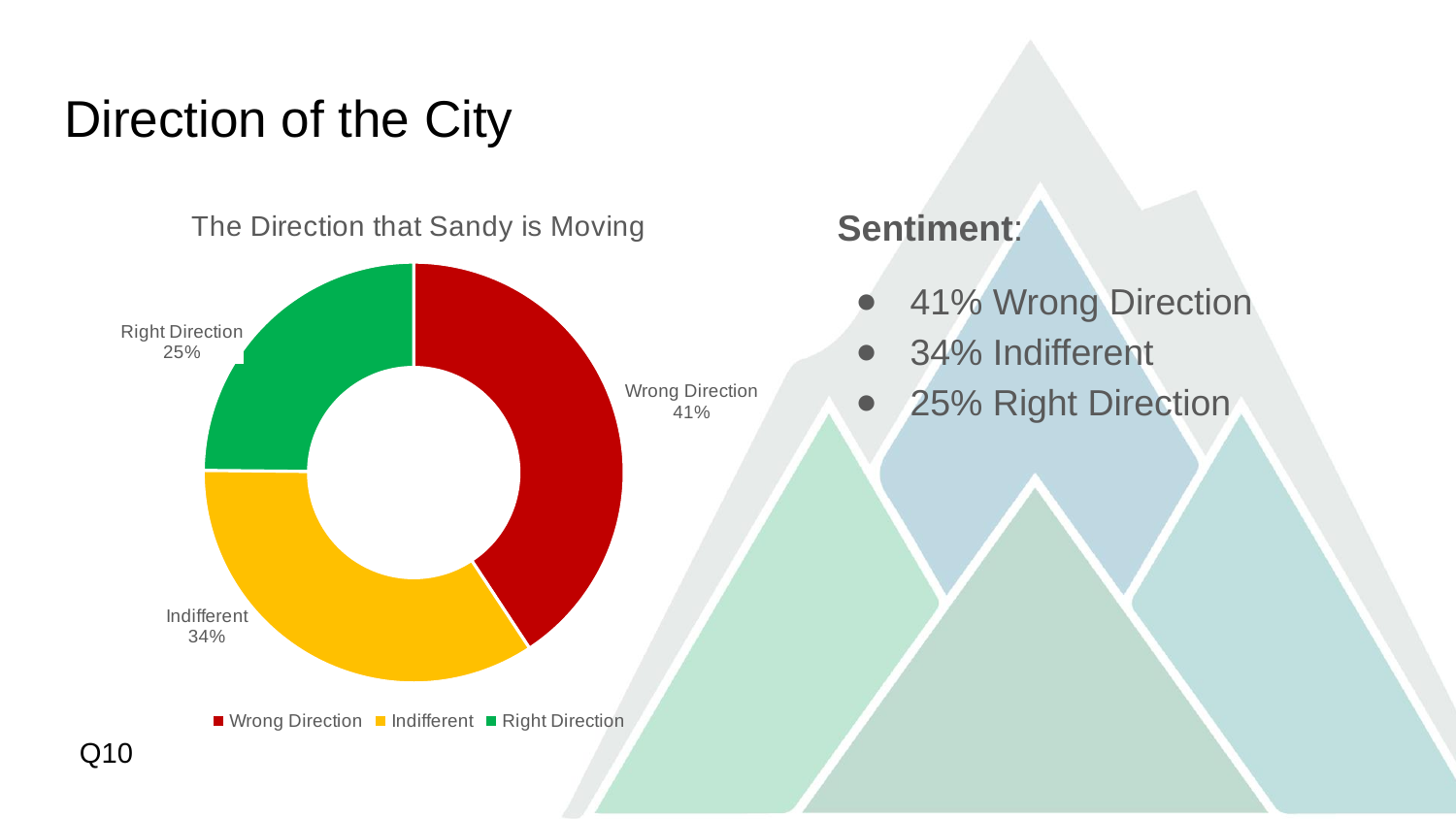
How many percentage points larger is Wrong Direction than Right Direction? 16 Which category has the largest share in the chart? Wrong Direction What is the title of the chart? The Direction that Sandy is Moving What percentage is shown for Right Direction? 25% What share of the donut chart is labelled Indifferent? 34% What is the difference in percentage points between Indifferent and Right Direction? 9 What percentage of respondents said Sandy is moving in the Wrong Direction? 41% What colour represents Wrong Direction in the chart? Red Which category has the smallest share in the chart? Right Direction What type of chart is shown on the slide? Donut (pie) chart How many categories does the chart show? 3 Which is larger, the share for Indifferent or the share for Right Direction? Indifferent